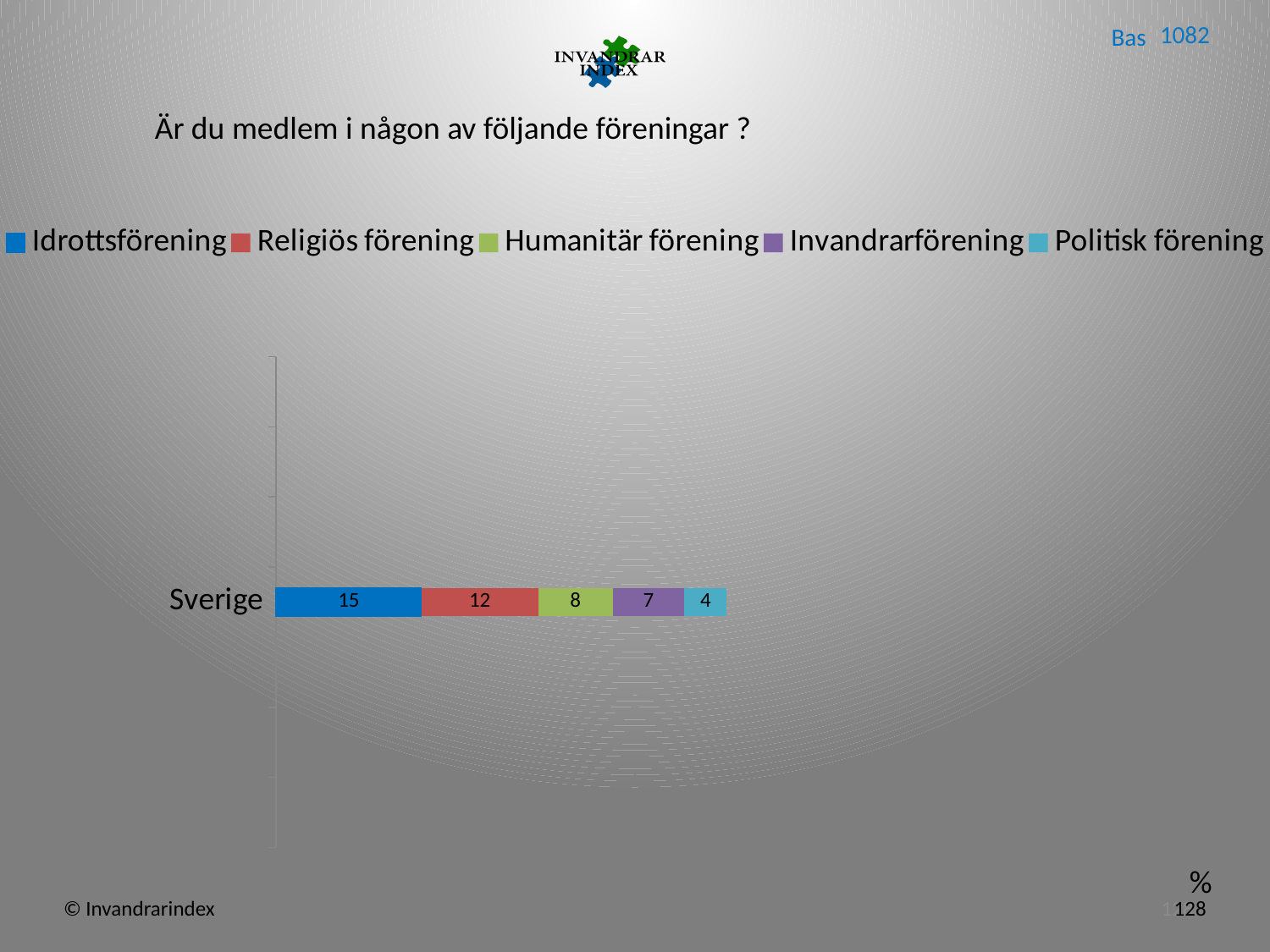
How many series does the legend list? 5 What is the value for Invandrarförening for Sverige? 7 Which is larger for Sverige, Humanitär förening or Invandrarförening? Humanitär förening What is the value for Humanitär förening for Sverige? 8 What is the value for Religiös förening for Sverige? 12 Which series has the lowest value for Sverige? Politisk förening Which series has the highest value for Sverige? Idrottsförening What is the difference between the Idrottsförening and Religiös förening values for Sverige? 3 What is the value for Idrottsförening for Sverige? 15 What is the total of the stacked bar for Sverige? 46 What kind of chart is shown on the slide? Stacked bar chart What is the value for Politisk förening for Sverige? 4